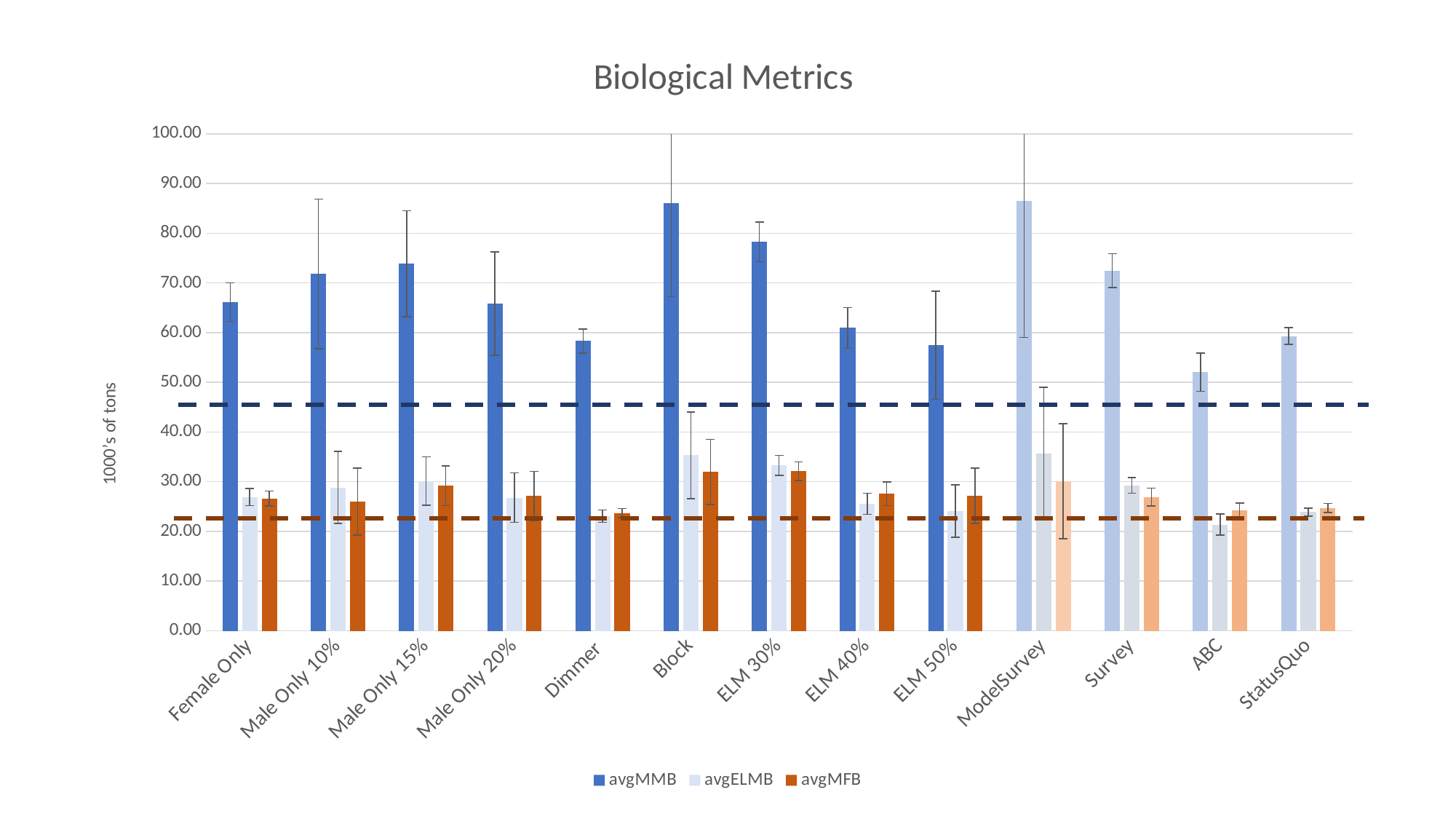
Which category has the lowest avgMMB value? ABC What type of chart is shown on the slide? bar chart Is the avgMMB value for Block greater or less than 80.00? greater Is the avgMMB value for ELM 30% greater or less than 70.00? greater Which is larger, the avgMMB value for ELM 30% or the avgMMB value for ELM 50%? ELM 30% How many series does the legend list? 3 What is the label on the vertical axis? 1000's of tons Is the avgELMB value for Female Only greater or less than 30.00? less Which is larger, the avgMMB value for Block or the avgMMB value for Dimmer? Block How many categories are shown along the x axis? 13 What is the title of the chart? Biological Metrics